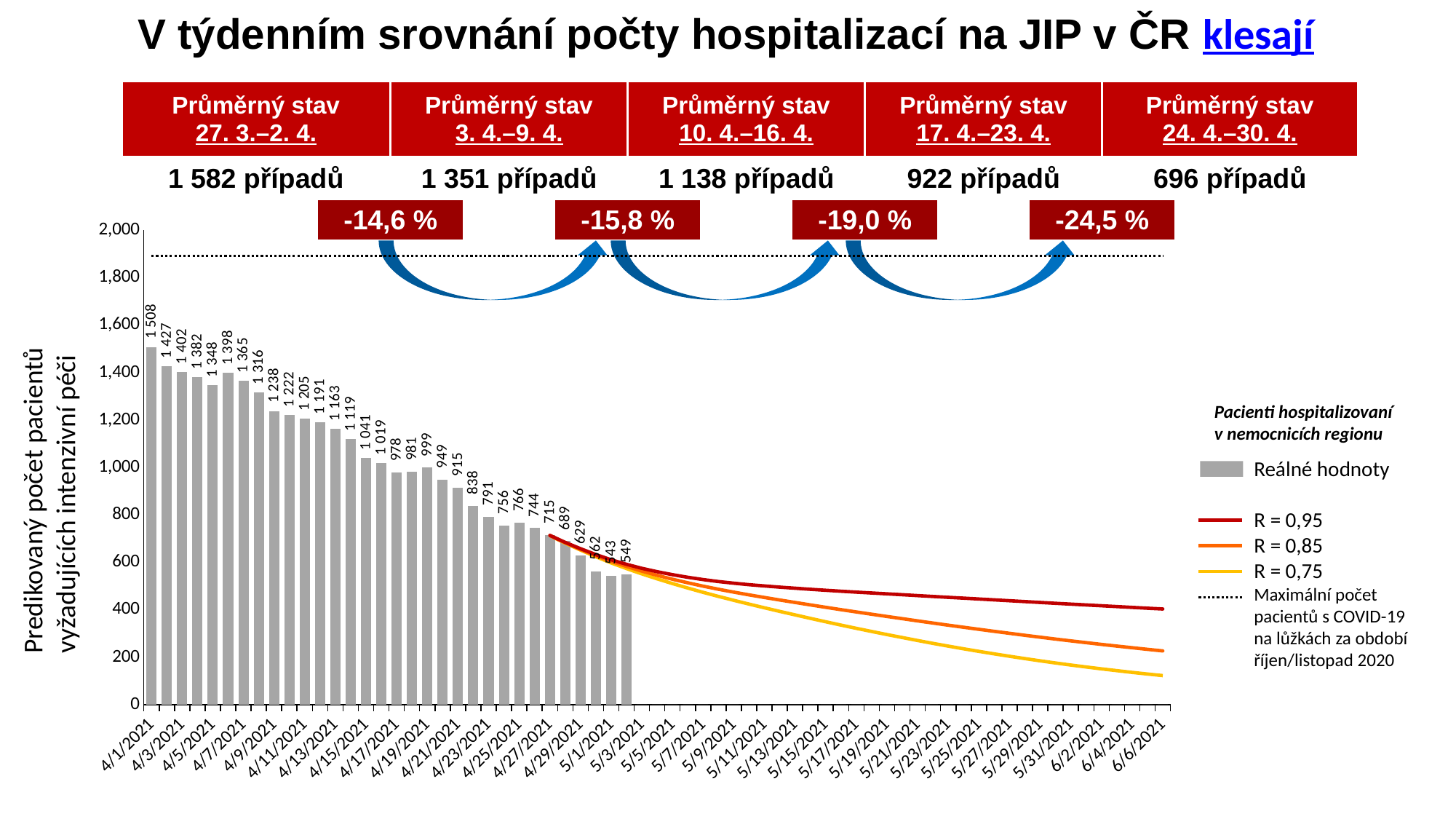
Which is larger, the bar for 4/1/2021 or the last bar on 5/3/2021? 4/1/2021 What is the value of the lowest bar in the chart? 543 Which date has the highest bar in the chart? 4/1/2021 What percentage change is shown between the periods 10. 4.–16. 4. and 17. 4.–23. 4.? -19,0 % Do the bar values rise or fall from 4/1/2021 to 5/3/2021? fall What is the difference between the first bar (1 508) and the last bar (549)? 959 Is the value of the R = 0,75 line at 6/6/2021 greater or less than 200? less Is the value of the R = 0,95 line at 6/6/2021 greater or less than 200? greater What kind of chart is shown on the slide? bar chart with line series What does the dotted horizontal line in the chart represent according to the legend? Maximální počet pacientů s COVID-19 na lůžkách za období říjen/listopad 2020 What is the value of the bar for 4/1/2021? 1 508 How many entries does the chart legend list? 5